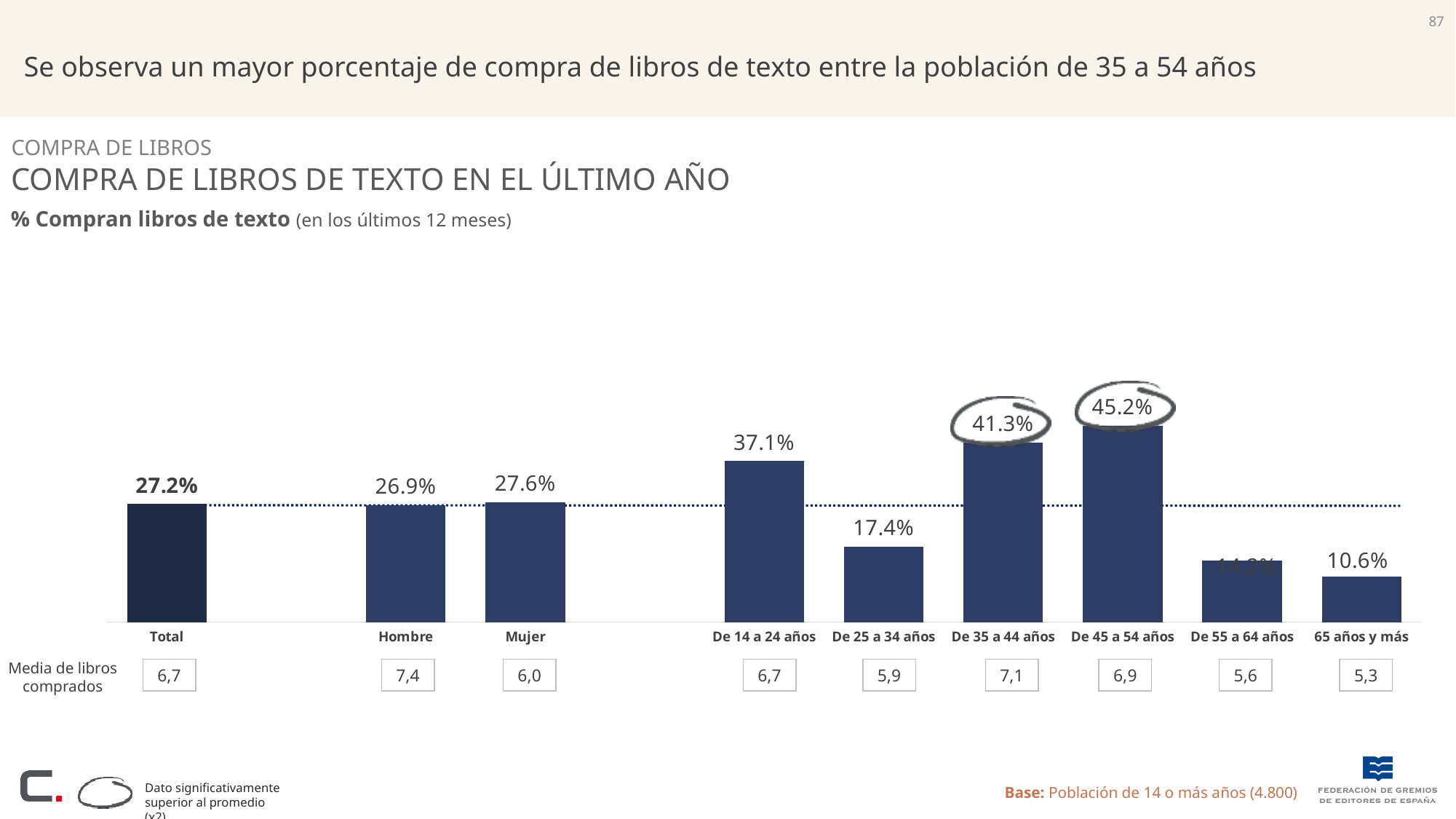
What percentage of the Total population bought textbooks in the last 12 months? 27.2% What is the value shown for 'De 14 a 24 años'? 37.1% Which category has the lowest percentage of textbook buyers? 65 años y más What is the difference in percentage points between 'De 45 a 54 años' and 'De 35 a 44 años'? 3.9 What kind of chart is shown on the slide? Bar chart What is the 'Media de libros comprados' value for '65 años y más'? 5,3 Which has a higher percentage of textbook buyers, Hombre or Mujer? Mujer What is the title of the chart section on the slide? COMPRA DE LIBROS DE TEXTO EN EL ÚLTIMO AÑO What is the value shown for 'De 25 a 34 años'? 17.4% How many bars are plotted in the chart? 9 Which category has the highest percentage of textbook buyers? De 45 a 54 años What is the 'Media de libros comprados' value for Hombre? 7,4